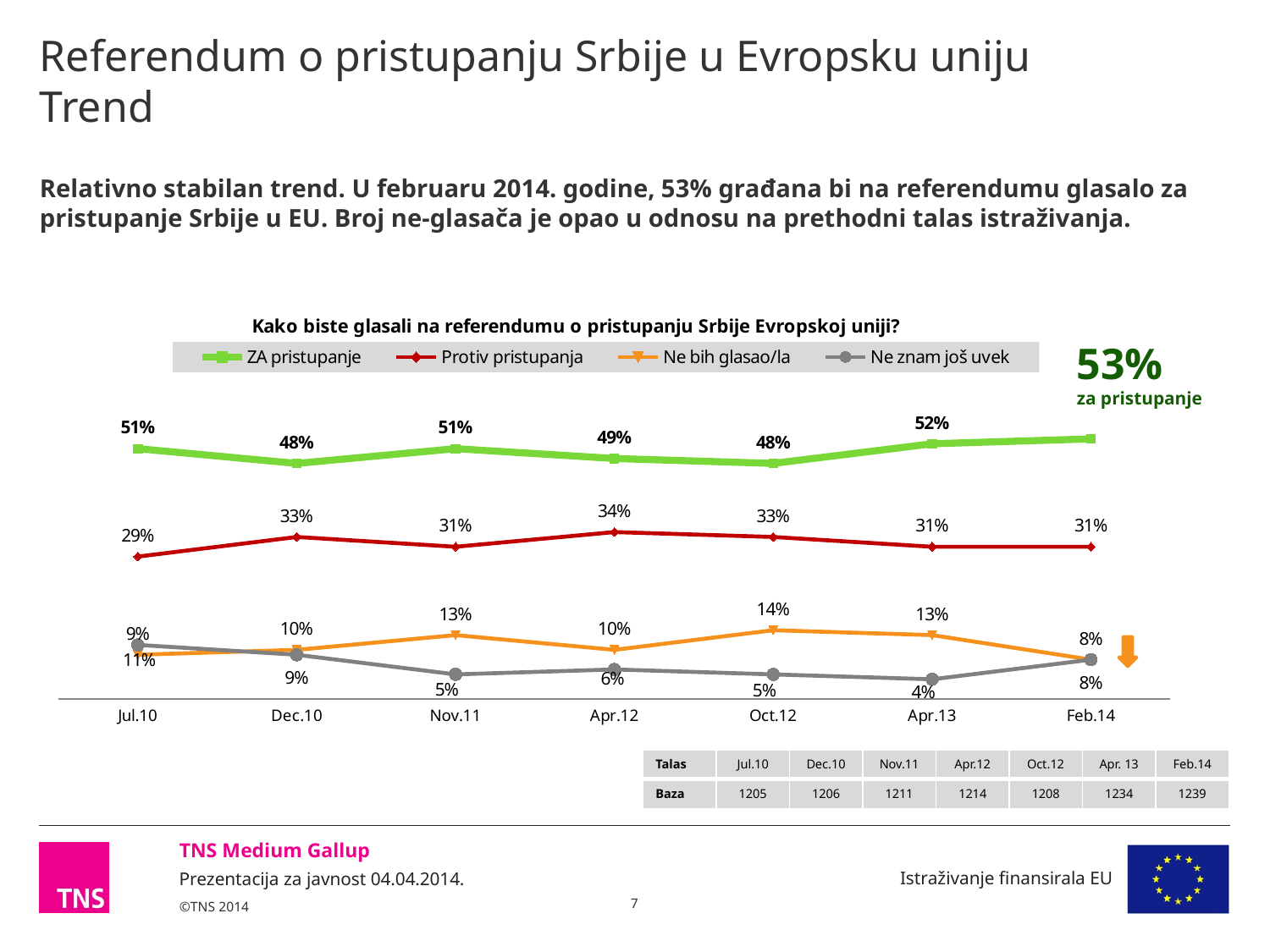
Does ZA pristupanje rise or fall from Oct.12 to Feb.14? Rise In Oct.12, which is larger: Ne bih glasao/la or Ne znam još uvek? Ne bih glasao/la What is the difference between ZA pristupanje and Protiv pristupanja in Feb.14? 22 percentage points In which wave does Ne bih glasao/la reach its highest value? Oct.12 What is the value for ZA pristupanje in Feb.14? 53% What kind of chart is shown on the slide? Line chart In which wave is ZA pristupanje at its highest? Feb.14 How many survey waves (points along the x axis) are plotted in the chart? 7 What is the value for Ne znam još uvek in Apr.13? 4% In which wave is Protiv pristupanja at its lowest? Jul.10 How many series does the chart legend list? 4 What is the value for Protiv pristupanja in Apr.12? 34%